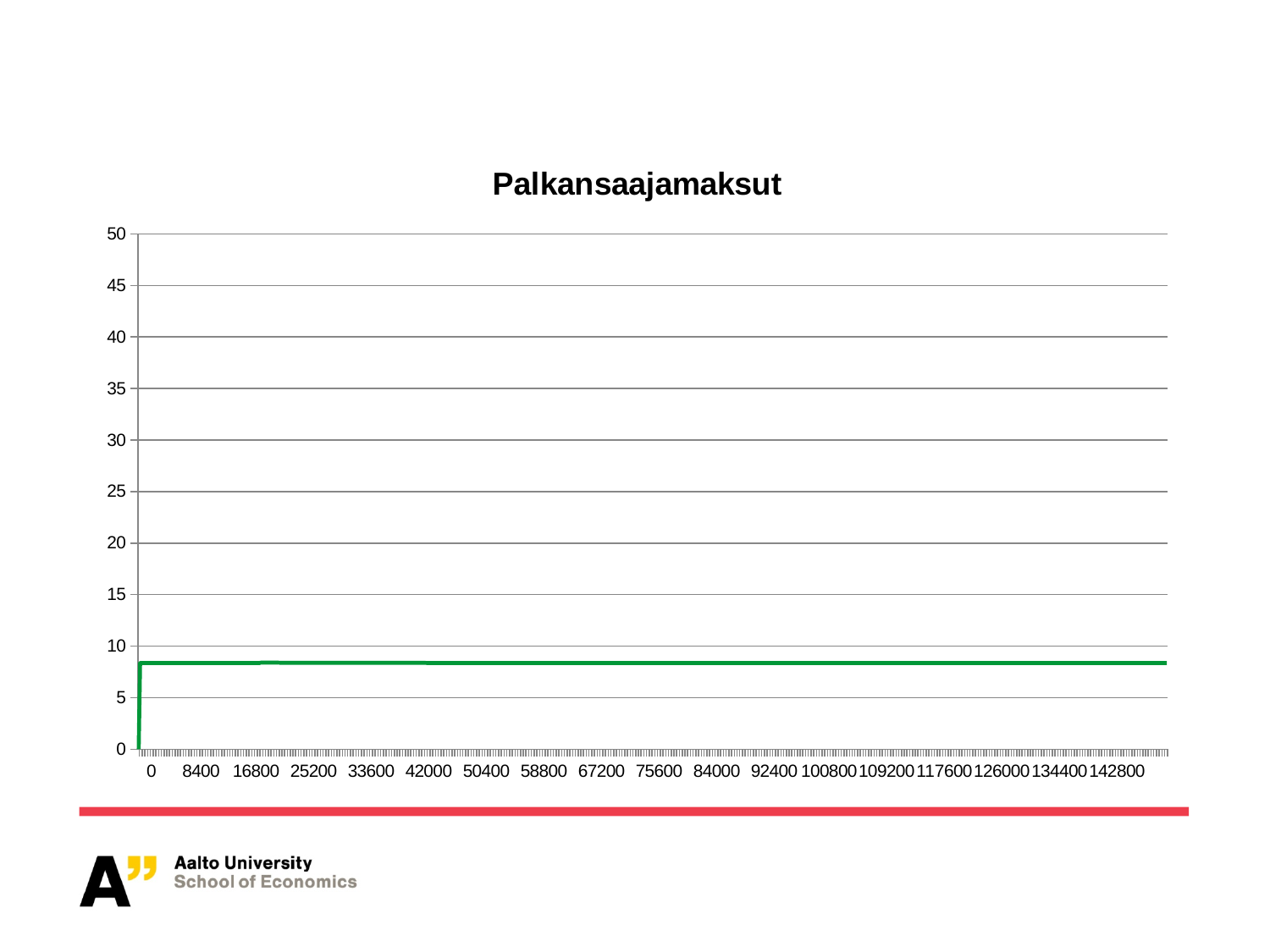
Does the line rise, fall, or stay flat from 8400 to 142800? stays flat What is the value of the line at x = 0? 0 What is the title of the chart? Palkansaajamaksut What colour is the line plotted in the chart? green Which has the larger value, x = 0 or x = 84000? 84000 Does the line rise or fall between x = 0 and x = 8400? rise Is the value for 84000 greater or less than 5? greater Is the value for 84000 greater or less than 10? less What kind of chart is shown on the slide? line chart Is the value for 42000 greater or less than 5? greater